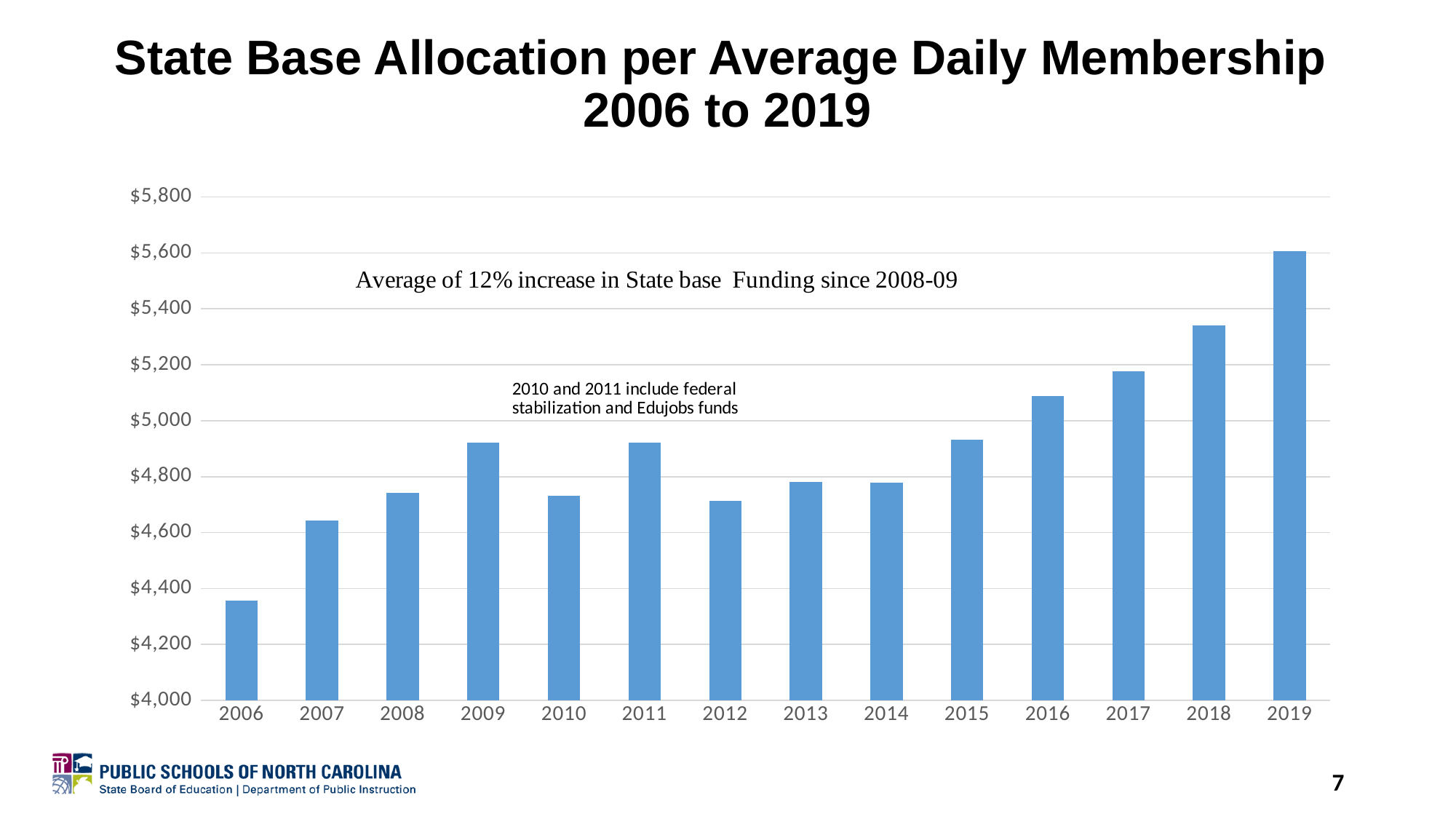
Which year has the highest State base allocation per ADM? 2019 Is the value for 2006 greater or less than $4,400? less How many years are plotted on the chart? 14 What kind of chart is shown on the slide? Bar chart Do the values generally rise or fall from 2014 to 2019? Rise Is the value for 2018 greater or less than $5,400? less Is the value for 2019 greater or less than $5,400? greater Which year has the lowest State base allocation per ADM? 2006 Which is larger, the value for 2009 or the value for 2010? 2009 According to the annotation on the chart, which years include federal stabilization and Edujobs funds? 2010 and 2011